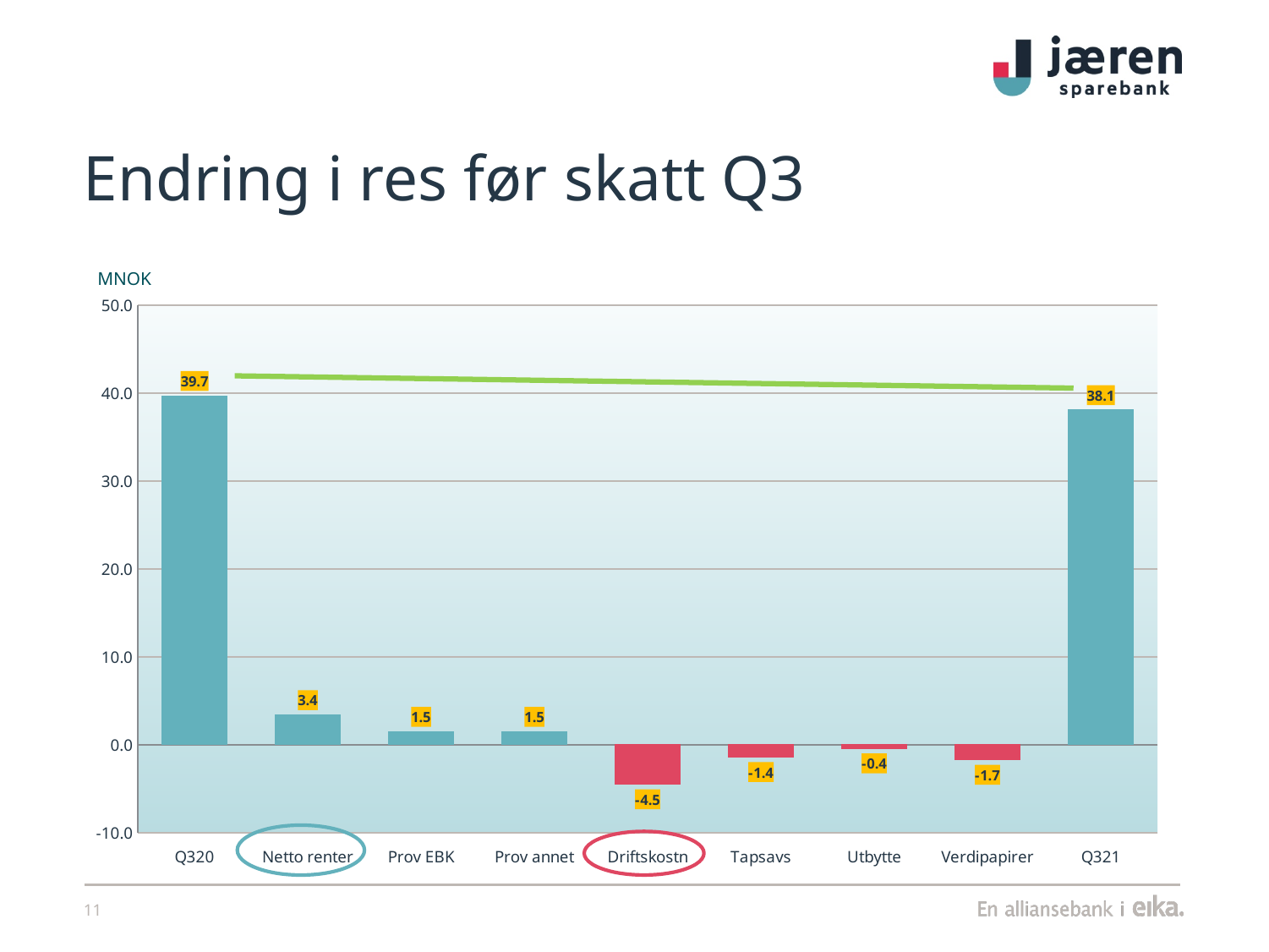
What is the value for Driftskostn? -4.5 What is the value for Q321? 38.1 What is the title of the chart on the slide? Endring i res før skatt Q3 What is the value for Verdipapirer? -1.7 What is the value for Netto renter? 3.4 Which category has the highest value? Q320 Which is larger, the value for Tapsavs or the value for Utbytte? Utbytte How many categories are shown on the x axis? 9 What kind of chart is shown on the slide? Bar chart What is the value for Q320? 39.7 Which category has the lowest value? Driftskostn What is the difference between the values for Q320 and Q321? 1.6